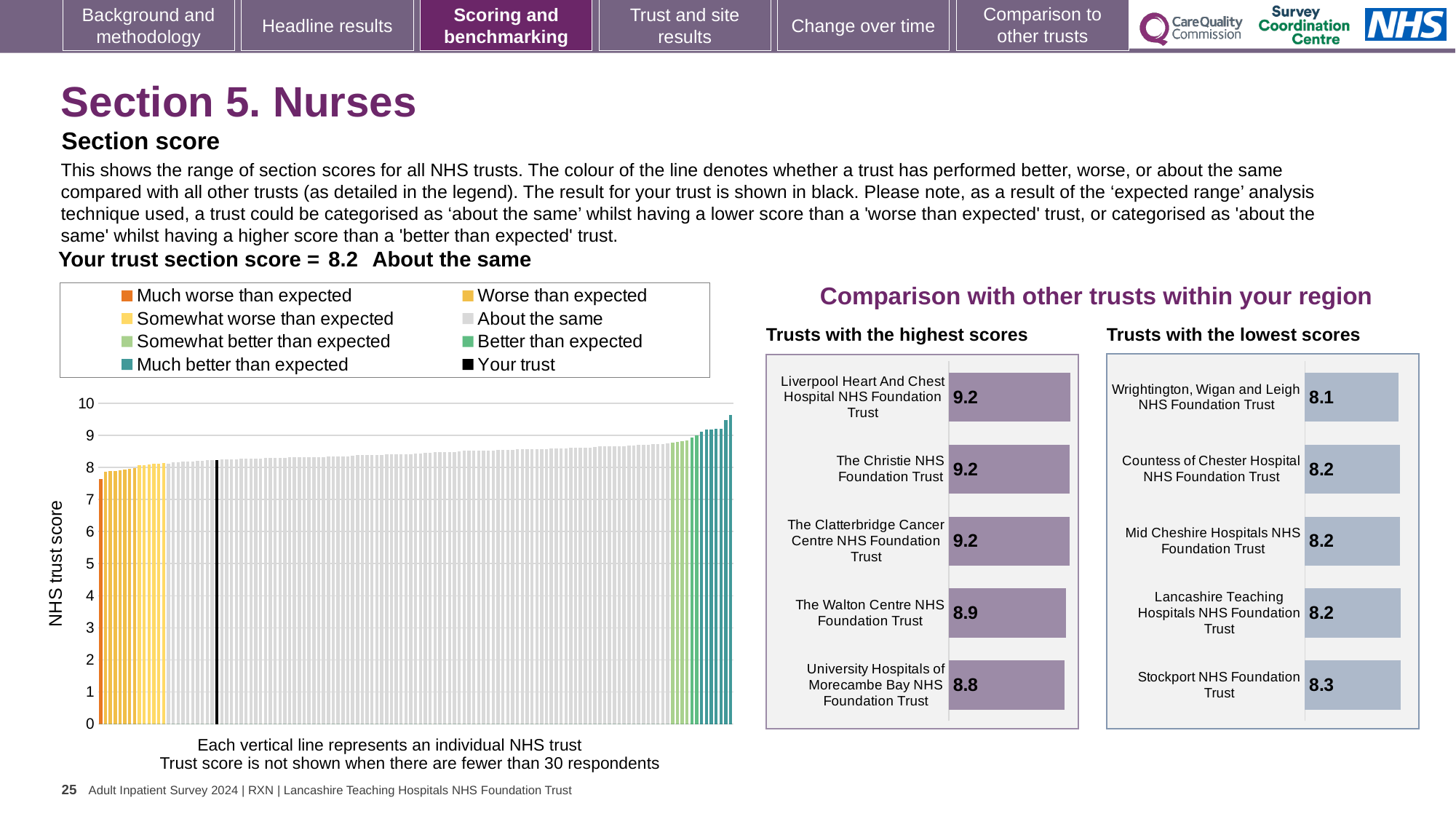
In the 'Trusts with the highest scores' chart, what is the score for The Walton Centre NHS Foundation Trust? 8.9 How many entries does the legend of the main NHS trust score chart list? 8 How many trusts are listed in the 'Trusts with the highest scores' chart? 5 In the 'Trusts with the lowest scores' chart, which trust has the highest score? Stockport NHS Foundation Trust In the 'Trusts with the highest scores' chart, which trust has the lowest score? University Hospitals of Morecambe Bay NHS Foundation Trust In the 'Trusts with the lowest scores' chart, what is the difference between the scores of Stockport NHS Foundation Trust and Wrightington, Wigan and Leigh NHS Foundation Trust? 0.2 In the 'Trusts with the highest scores' chart, which has the higher score: The Walton Centre NHS Foundation Trust or University Hospitals of Morecambe Bay NHS Foundation Trust? The Walton Centre NHS Foundation Trust In the 'Trusts with the lowest scores' chart, which trust has the lowest score? Wrightington, Wigan and Leigh NHS Foundation Trust What kind of chart is the main chart showing NHS trust scores on the left of the slide? Bar chart In the main NHS trust score chart on the left, do the bar values rise or fall from left to right? Rise In the 'Trusts with the highest scores' chart, what is the difference between the scores of Liverpool Heart And Chest Hospital NHS Foundation Trust and University Hospitals of Morecambe Bay NHS Foundation Trust? 0.4 In the 'Trusts with the lowest scores' chart, what is the score for Stockport NHS Foundation Trust? 8.3